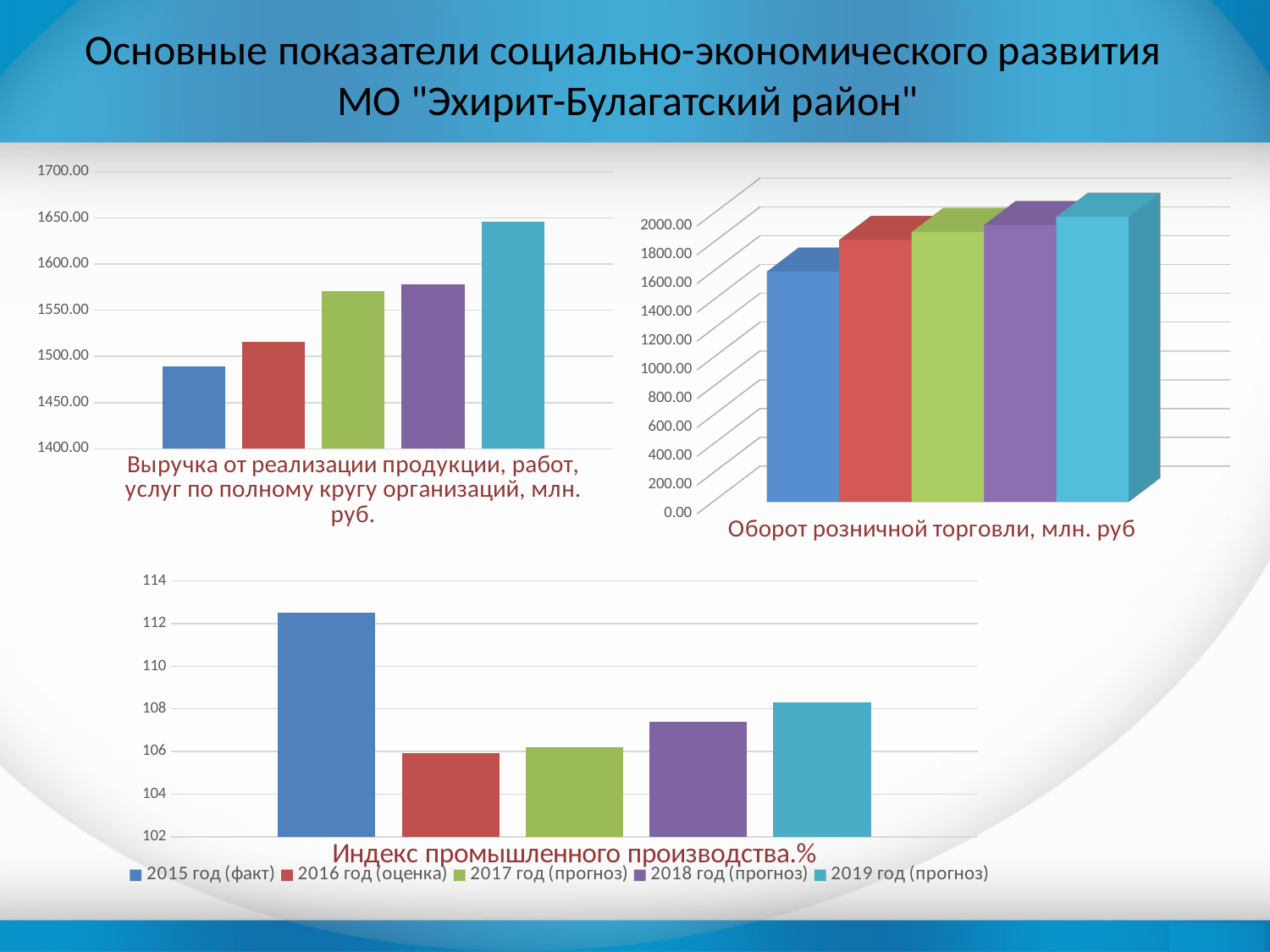
In the chart titled "Индекс промышленного производства,%", is the value for 2015 год (факт) greater or less than 110? greater In the chart titled "Индекс промышленного производства,%", which series has the highest value? 2015 год (факт) In the chart titled "Индекс промышленного производства,%", which is larger: the value for 2015 год (факт) or the value for 2019 год (прогноз)? 2015 год (факт) In the chart titled "Выручка от реализации продукции, работ, услуг по полному кругу организаций, млн. руб.", which series has the highest value? 2019 год (прогноз) In the chart titled "Выручка от реализации продукции, работ, услуг по полному кругу организаций, млн. руб.", is the value for 2019 год (прогноз) greater or less than 1600.00? greater How many series does the legend at the bottom of the slide list? 5 How many bars are plotted in the chart titled "Индекс промышленного производства,%"? 5 What kind of chart is the chart titled "Выручка от реализации продукции, работ, услуг по полному кругу организаций, млн. руб."? Bar chart In the chart titled "Оборот розничной торговли, млн. руб", is the value for 2015 год (факт) greater or less than 1800.00? less In the chart titled "Выручка от реализации продукции, работ, услуг по полному кругу организаций, млн. руб.", which series has the lowest value? 2015 год (факт) In the chart titled "Выручка от реализации продукции, работ, услуг по полному кругу организаций, млн. руб.", do the values rise or fall from 2015 to 2019? Rise In the chart titled "Оборот розничной торговли, млн. руб", which series has the lowest value? 2015 год (факт)